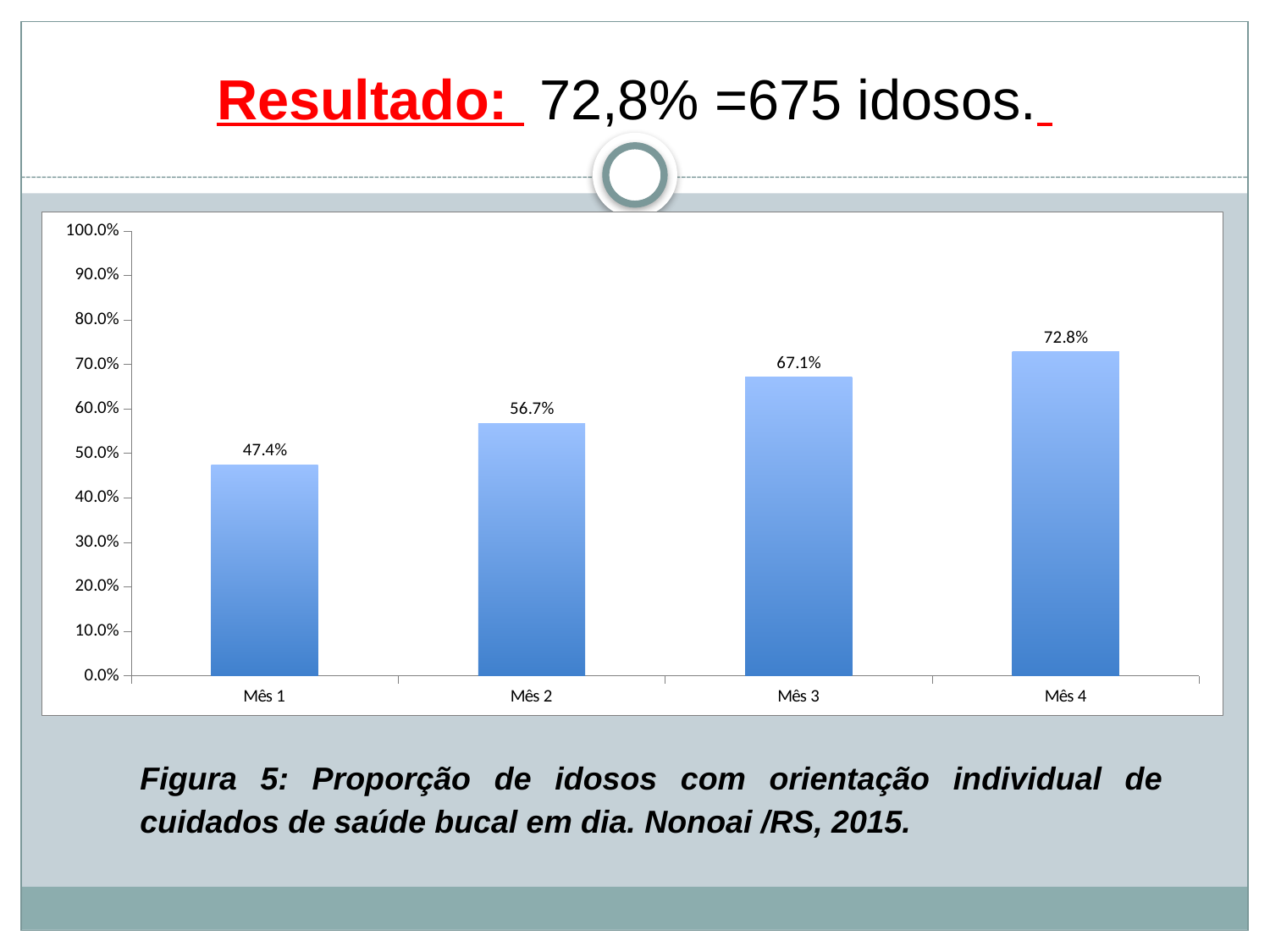
Which month has the lowest value? Mês 1 How many months are shown on the x axis? 4 What is the difference between the values for Mês 3 and Mês 2? 10.4% What is the value for Mês 4? 72.8% Which month has the highest value? Mês 4 Which is larger, the value for Mês 2 or the value for Mês 3? Mês 3 What is the value for Mês 2? 56.7% What is the value for Mês 3? 67.1% What kind of chart is shown on the slide? Bar chart Do the values rise or fall from Mês 1 to Mês 4? Rise What is the value for Mês 1? 47.4% What is the difference between the values for Mês 4 and Mês 1? 25.4%